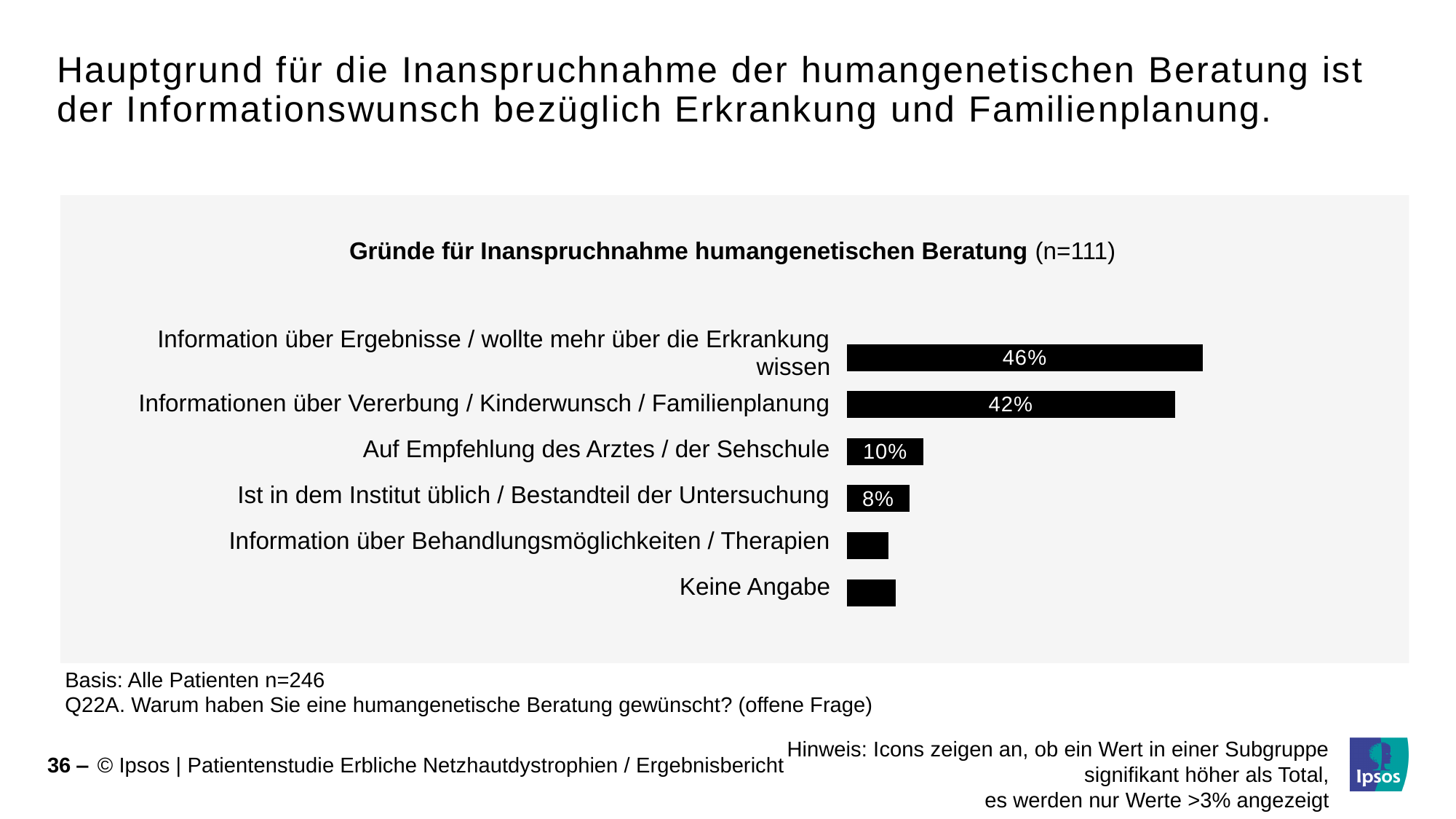
How many categories are shown in the chart? 6 What is the value for "Auf Empfehlung des Arztes / der Sehschule"? 10% Which category has the highest value? Information über Ergebnisse / wollte mehr über die Erkrankung wissen What is the value for "Ist in dem Institut üblich / Bestandteil der Untersuchung"? 8% What is the value for "Information über Ergebnisse / wollte mehr über die Erkrankung wissen"? 46% What is the difference between the values for "Auf Empfehlung des Arztes / der Sehschule" and "Ist in dem Institut üblich / Bestandteil der Untersuchung"? 2 percentage points How many categories in the chart have no data label printed? 2 What is the value for "Informationen über Vererbung / Kinderwunsch / Familienplanung"? 42% What is the difference between the values for "Information über Ergebnisse / wollte mehr über die Erkrankung wissen" and "Informationen über Vererbung / Kinderwunsch / Familienplanung"? 4 percentage points What is the title of the chart? Gründe für Inanspruchnahme humangenetischen Beratung (n=111) What kind of chart is shown on the slide? Bar chart Which is larger: the value for "Auf Empfehlung des Arztes / der Sehschule" or for "Ist in dem Institut üblich / Bestandteil der Untersuchung"? Auf Empfehlung des Arztes / der Sehschule